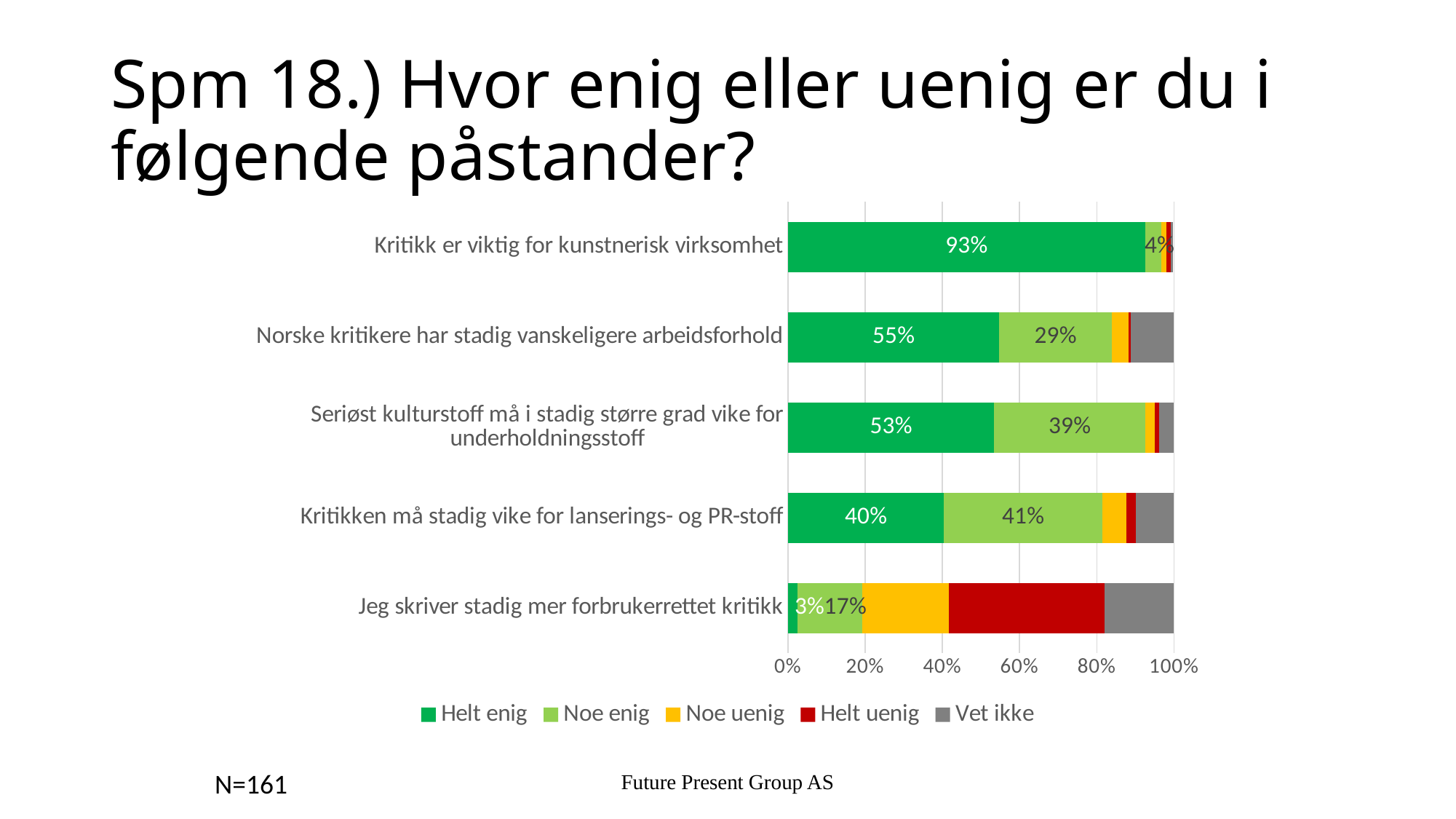
How many statements (categories) are plotted in the chart? 5 What is the difference between the 'Helt enig' values for 'Norske kritikere har stadig vanskeligere arbeidsforhold' and 'Seriøst kulturstoff må i stadig større grad vike for underholdningsstoff'? 2% What is the 'Noe enig' value for 'Kritikken må stadig vike for lanserings- og PR-stoff'? 41% What is the 'Helt enig' value for 'Seriøst kulturstoff må i stadig større grad vike for underholdningsstoff'? 53% How many series does the legend list? 5 What kind of chart is shown on the slide? Stacked bar chart Which statement has the highest 'Helt enig' share? Kritikk er viktig for kunstnerisk virksomhet What is the 'Helt enig' value for 'Kritikk er viktig for kunstnerisk virksomhet'? 93% Is the 'Helt uenig' value for 'Jeg skriver stadig mer forbrukerrettet kritikk' greater or less than 20%? greater What is the 'Noe enig' value for 'Norske kritikere har stadig vanskeligere arbeidsforhold'? 29% What is the 'Noe enig' value for 'Jeg skriver stadig mer forbrukerrettet kritikk'? 17% Which statement has the lowest 'Helt enig' share? Jeg skriver stadig mer forbrukerrettet kritikk